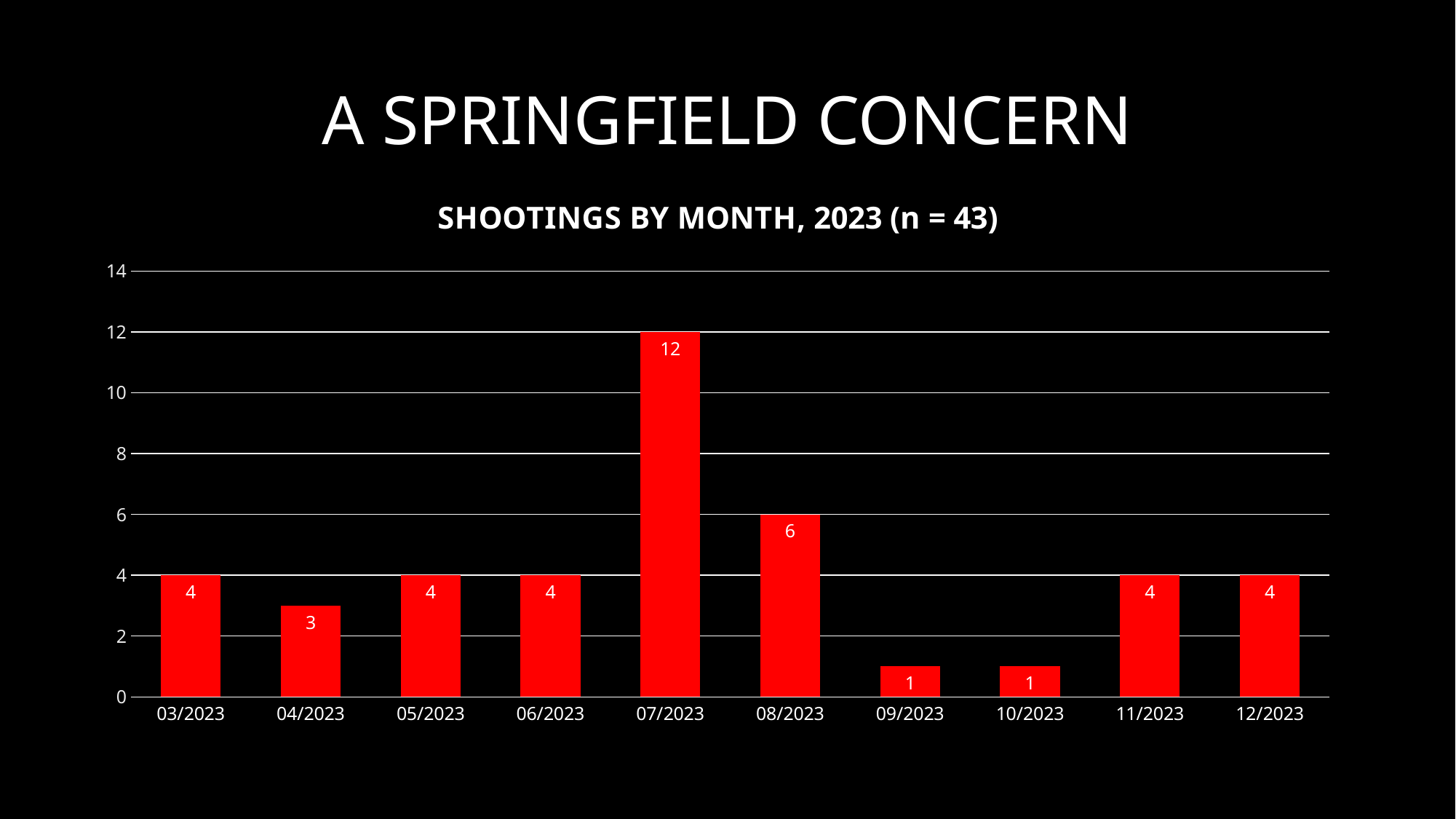
What kind of chart is shown on the slide? bar chart What is the title of the chart? SHOOTINGS BY MONTH, 2023 (n = 43) Do the values rise or fall from 08/2023 to 09/2023? fall How many months are shown on the x axis? 10 What is the value for 04/2023? 3 Which month has the highest number of shootings? 07/2023 What is the difference between the values for 07/2023 and 08/2023? 6 What is the value for 08/2023? 6 Which is larger, the value for 04/2023 or the value for 08/2023? 08/2023 What colour are the bars in the chart? red What is the value for 07/2023? 12 Is the value for 07/2023 greater or less than 10? greater